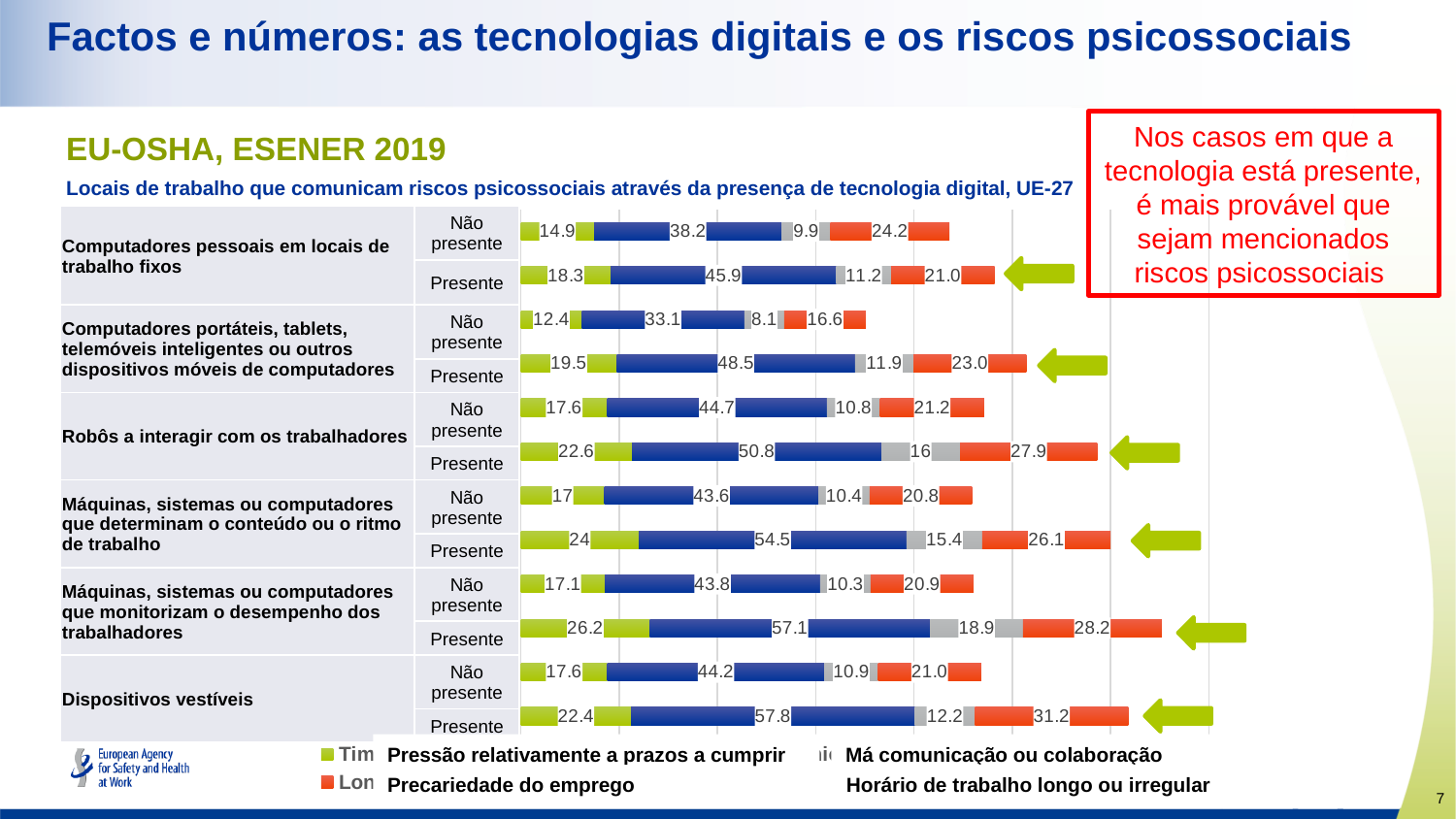
What is the value of the blue (second) segment for 'Dispositivos vestíveis', Presente? 57.8 How many technology categories are listed on the left of the chart? 6 What is the value of the grey (third) segment for 'Máquinas, sistemas ou computadores que monitorizam o desempenho dos trabalhadores', Presente? 18.9 What is the difference between the blue segment values for 'Dispositivos vestíveis' Presente and Não presente? 13.6 For 'Máquinas, sistemas ou computadores que determinam o conteúdo ou o ritmo de trabalho', is the green segment larger for Presente or Não presente? Presente What is the total of the stacked bar for 'Computadores pessoais em locais de trabalho fixos', Não presente? 87.2 Which bar has the smallest green (first) segment? Computadores portáteis, tablets, telemóveis inteligentes ou outros dispositivos móveis de computadores, Não presente How many series does the chart legend list? 4 What is the value of the orange (last) segment for 'Computadores pessoais em locais de trabalho fixos', Não presente? 24.2 What kind of chart is shown on the slide? Stacked bar chart Which bar has the largest blue (second) segment? Dispositivos vestíveis, Presente What is the value of the green (first) segment for 'Robôs a interagir com os trabalhadores', Presente? 22.6